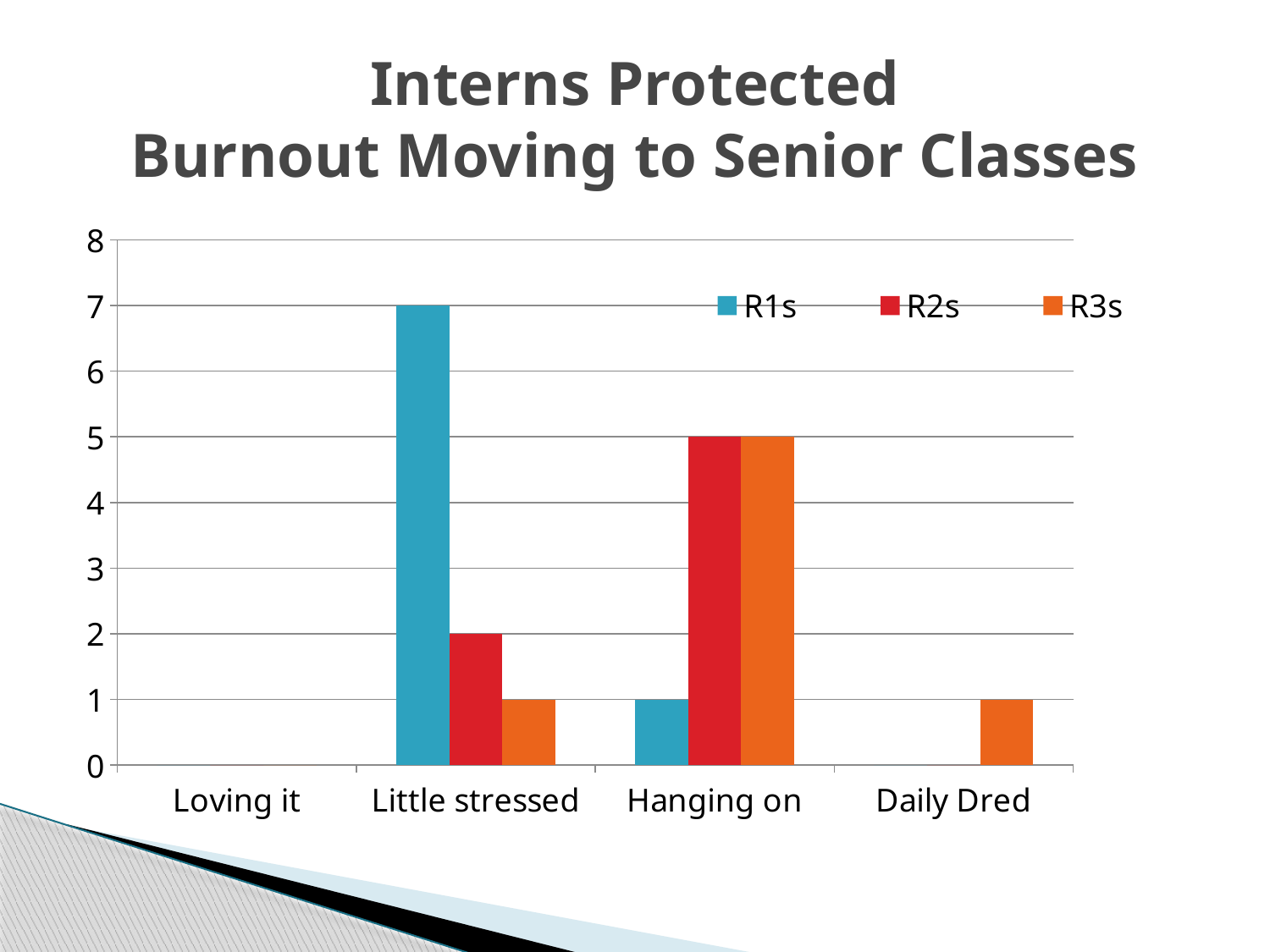
What is the difference between the R1s value and the R2s value in the Little stressed category? 5 What is the value for R2s in the Little stressed category? 2 What is the value for R1s in the Little stressed category? 7 What is the value for R2s in the Hanging on category? 5 How many series does the legend list? 3 Which series is shown in orange in the legend? R3s Which is larger in the Hanging on category, the R1s value or the R3s value? R3s What is the value for R3s in the Daily Dred category? 1 What kind of chart is shown on the slide? bar chart Which category has the highest value for R1s? Little stressed How many categories are shown on the x axis? 4 Is the value for R1s in the Little stressed category greater or less than 5? greater